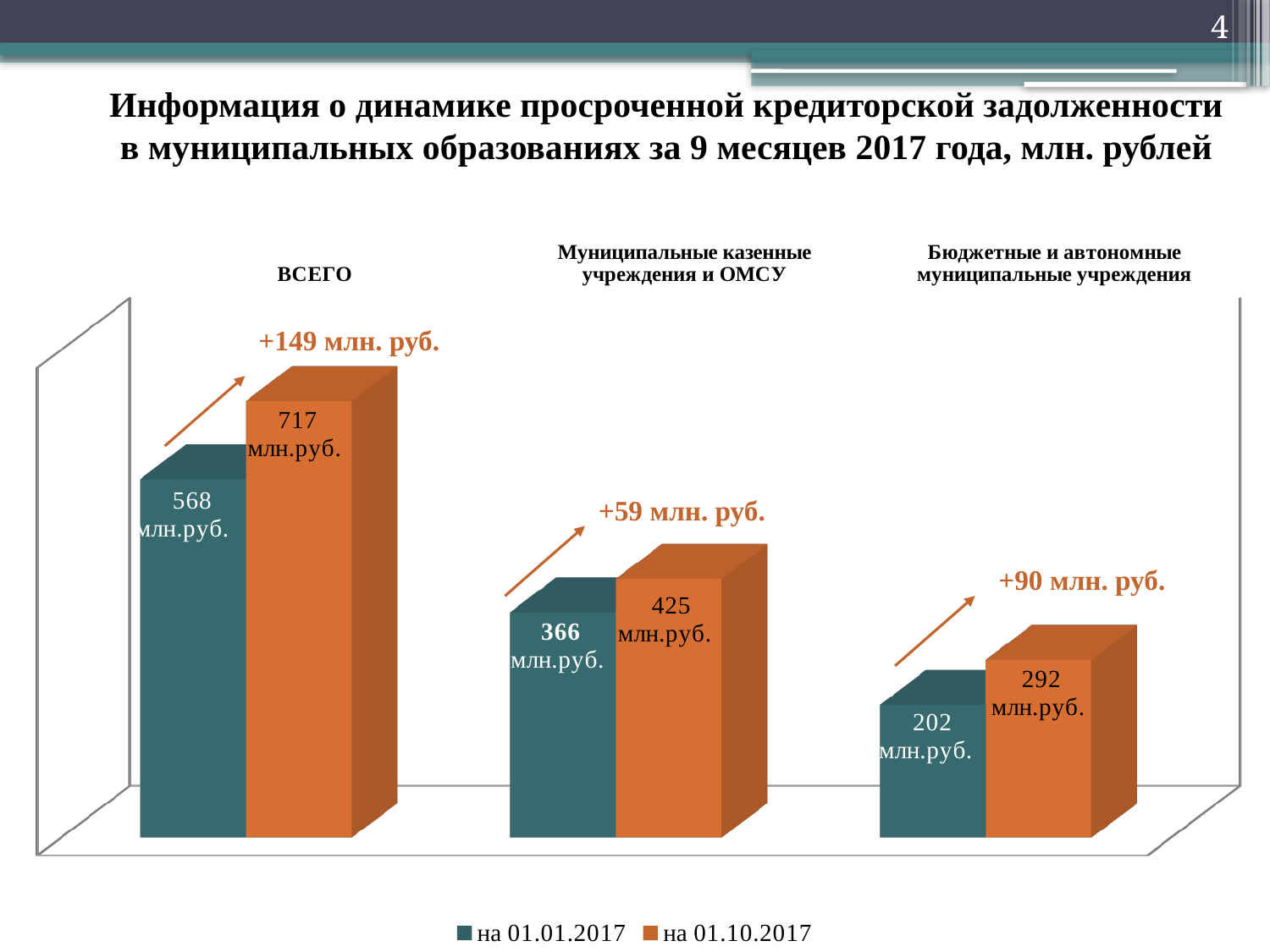
What is the difference between the 01.10.2017 and 01.01.2017 values for Муниципальные казенные учреждения и ОМСУ? 59 млн. руб. Which category has the highest value on 01.10.2017? ВСЕГО What kind of chart is shown on the slide? Bar chart Which category has the lowest value on 01.01.2017? Бюджетные и автономные муниципальные учреждения By how much did the value for Бюджетные и автономные муниципальные учреждения change from 01.01.2017 to 01.10.2017? +90 млн. руб. What is the value for ВСЕГО on 01.10.2017? 717 млн.руб. How many categories are shown on the chart? 3 How many series does the legend list? 2 What is the value for Бюджетные и автономные муниципальные учреждения on 01.01.2017? 202 млн.руб. Which is larger for Муниципальные казенные учреждения и ОМСУ: the value on 01.01.2017 or on 01.10.2017? на 01.10.2017 What is the value for ВСЕГО on 01.01.2017? 568 млн.руб. What is the value for Муниципальные казенные учреждения и ОМСУ on 01.10.2017? 425 млн.руб.